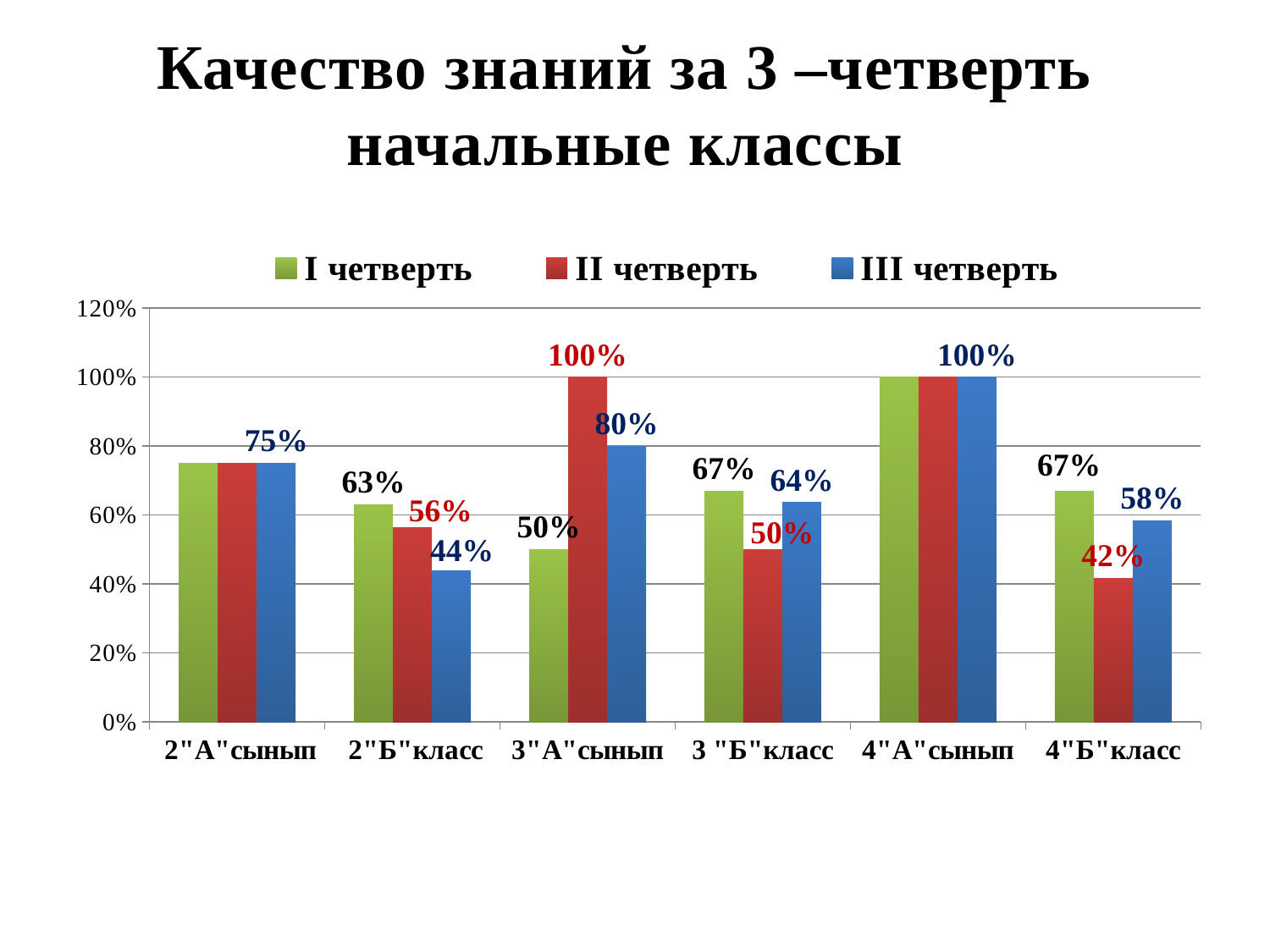
What is the value for III четверть for 2"Б"класс? 44% What is the value for I четверть for 3 "Б"класс? 67% What is the value for II четверть for 3"А"сынып? 100% What is the value for II четверть for 4"Б"класс? 42% Which series is shown in blue in the legend? III четверть What kind of chart is shown on the slide? bar chart Which is larger for 4"Б"класс: the I четверть value or the III четверть value? I четверть How many series does the legend list? 3 What is the difference between the II четверть and III четверть values for 3"А"сынып? 20% Which class has the lowest III четверть value? 2"Б"класс How many classes (categories) are shown on the x axis? 6 Which class has the highest I четверть value? 4"А"сынып